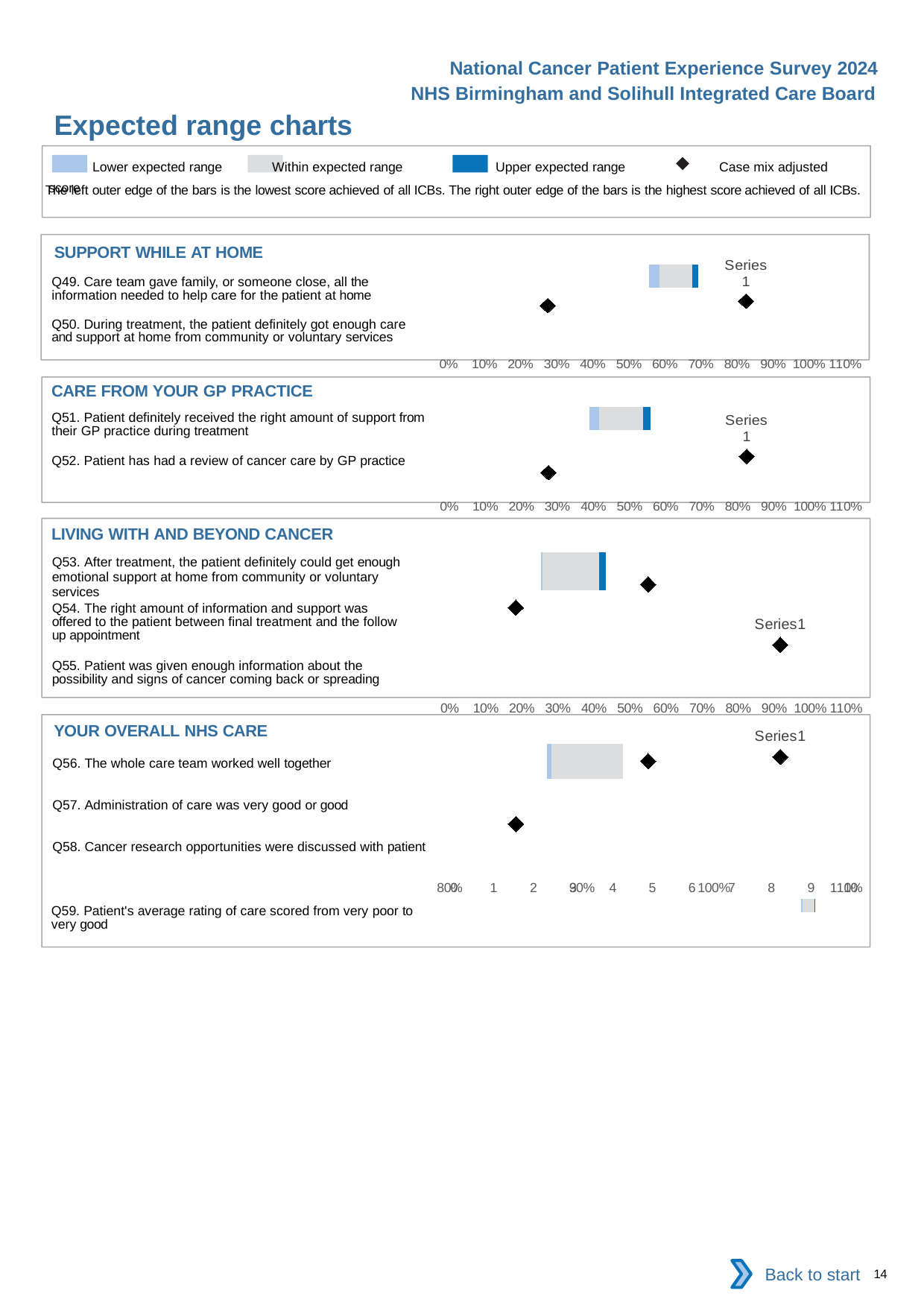
Which legend entry is shown in dark blue? Upper expected range How many case mix adjusted score diamond markers are shown in the 'SUPPORT WHILE AT HOME' chart? 2 How many questions are listed in the 'LIVING WITH AND BEYOND CANCER' chart? 3 In the 'YOUR OVERALL NHS CARE' chart, is the right edge of the expected range bar for the percentage axis greater or less than 60%? greater What is the highest tick label on the percentage axis of the 'CARE FROM YOUR GP PRACTICE' chart? 110% How many questions are listed in the 'CARE FROM YOUR GP PRACTICE' chart? 2 How many entries does the legend at the top of the slide list? 4 In the 'SUPPORT WHILE AT HOME' chart, is the left edge of the expected range bar greater or less than 50%? greater In the 'LIVING WITH AND BEYOND CANCER' chart, is the right edge of the expected range bar greater or less than 50%? less What kind of chart is used in the 'SUPPORT WHILE AT HOME' section? bar chart Which legend entry is shown with a black diamond marker? Case mix adjusted score